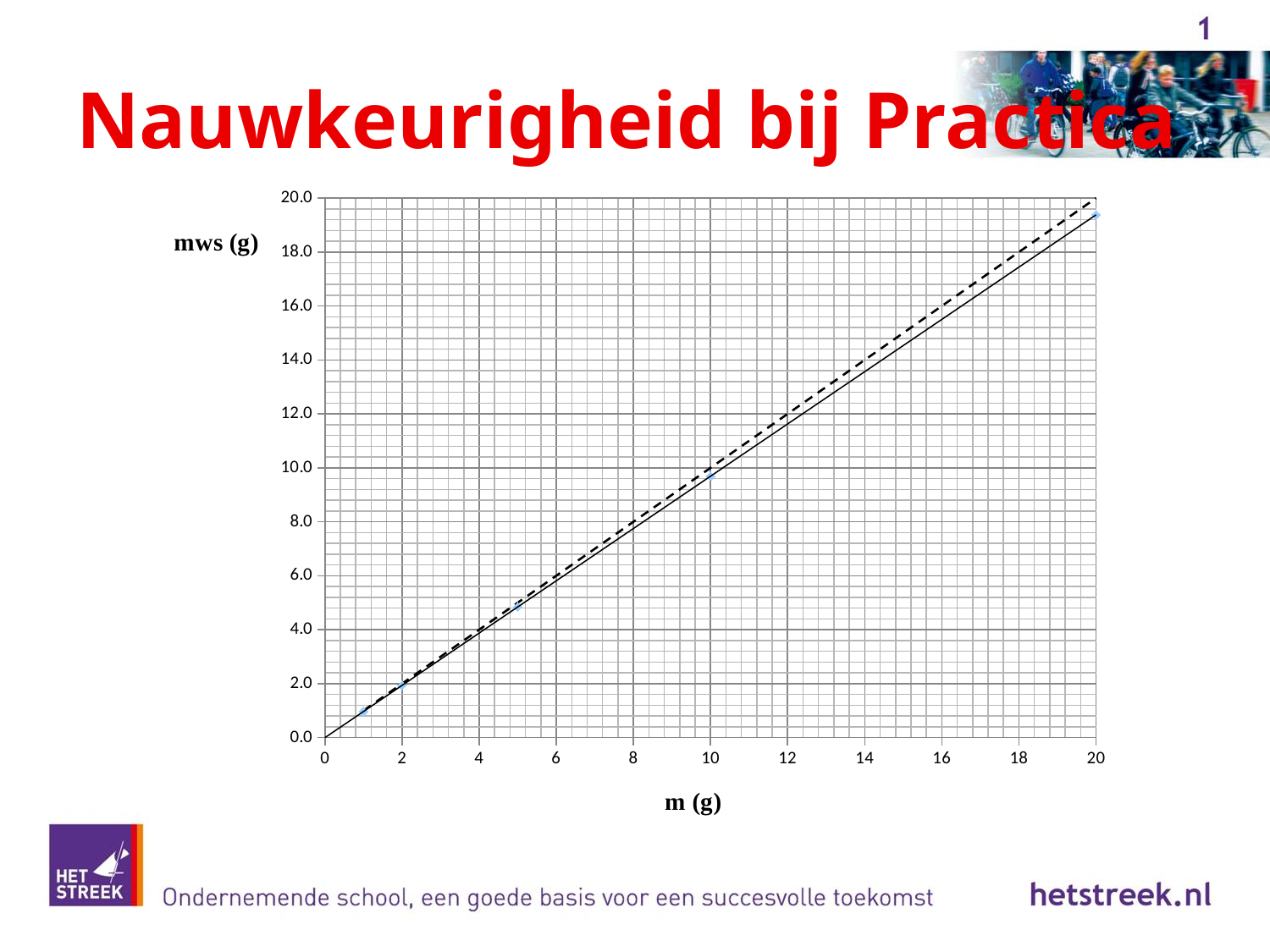
Is the plotted value of mws at m = 20 greater or less than 18.0? greater What is the highest value shown on the vertical axis of the chart? 20.0 Do the plotted values of mws rise or fall as m increases along the x axis? rise What is the label of the vertical axis of the chart? mws (g) How many lines are drawn on the chart? 2 Which of the two lines lies higher at m = 16, the dashed line or the solid line? the dashed line Is the plotted value of mws at m = 20 greater or less than 20.0? less What is the label of the horizontal axis of the chart? m (g) What kind of chart is shown on the slide? line chart Is the plotted value of mws at m = 5 greater or less than 6.0? less